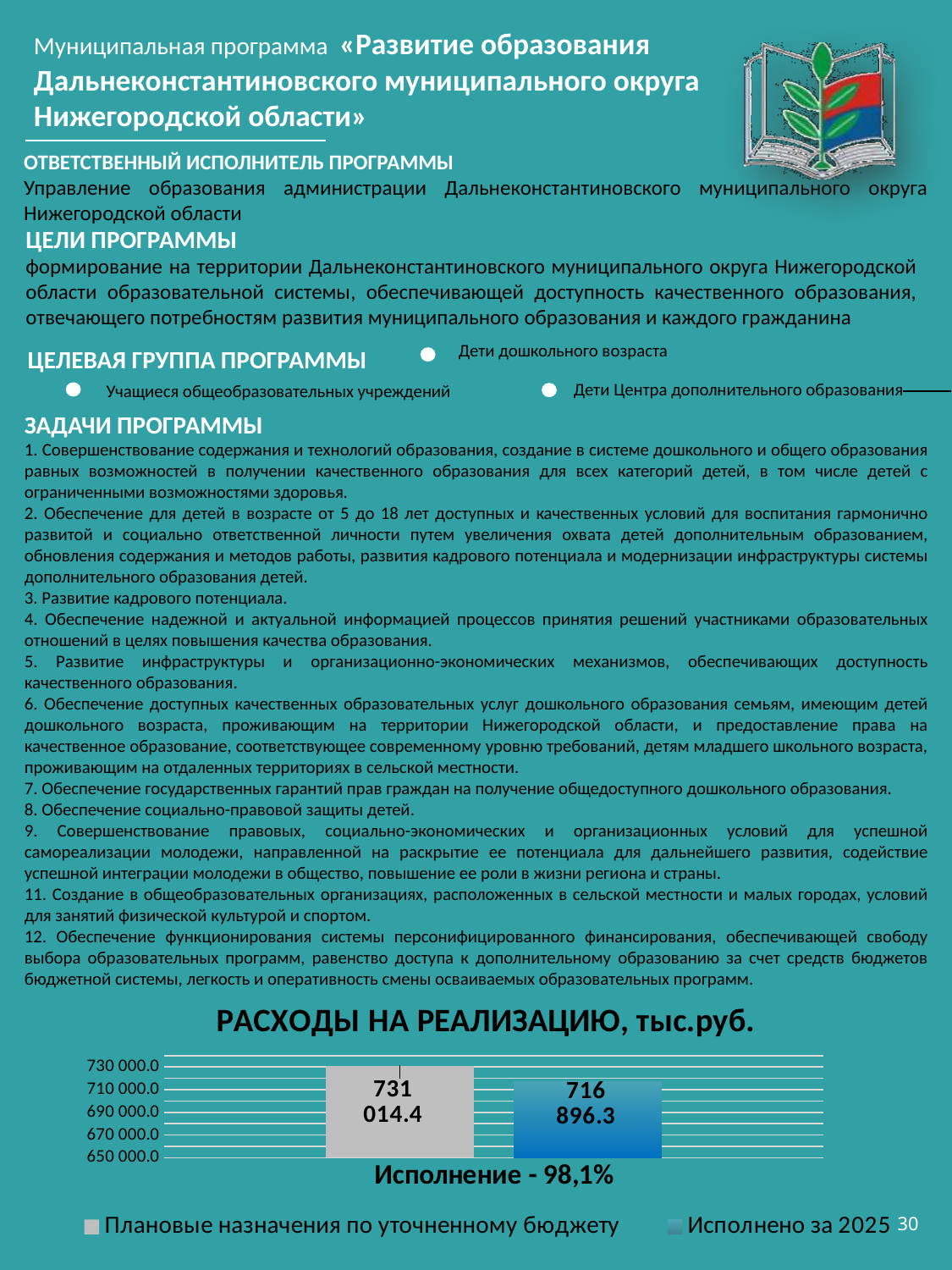
Which series has the lower value in the chart 'РАСХОДЫ НА РЕАЛИЗАЦИЮ, тыс.руб.'? Исполнено за 2025 How many series does the legend of the chart 'РАСХОДЫ НА РЕАЛИЗАЦИЮ, тыс.руб.' list? 2 What is the category label shown under the bars in the chart 'РАСХОДЫ НА РЕАЛИЗАЦИЮ, тыс.руб.'? Исполнение - 98,1% Is the value for 'Исполнено за 2025' in the chart 'РАСХОДЫ НА РЕАЛИЗАЦИЮ, тыс.руб.' greater or less than 730 000.0? less In the chart 'РАСХОДЫ НА РЕАЛИЗАЦИЮ, тыс.руб.', is the value for 'Исполнено за 2025' larger or smaller than the value for 'Плановые назначения по уточненному бюджету'? smaller What is the value of the bar for 'Плановые назначения по уточненному бюджету' in the chart 'РАСХОДЫ НА РЕАЛИЗАЦИЮ, тыс.руб.'? 731 014.4 How many bars are plotted in the chart 'РАСХОДЫ НА РЕАЛИЗАЦИЮ, тыс.руб.'? 2 What kind of chart is 'РАСХОДЫ НА РЕАЛИЗАЦИЮ, тыс.руб.'? bar chart What is the value of the bar for 'Исполнено за 2025' in the chart 'РАСХОДЫ НА РЕАЛИЗАЦИЮ, тыс.руб.'? 716 896.3 Which series has the higher value in the chart 'РАСХОДЫ НА РЕАЛИЗАЦИЮ, тыс.руб.'? Плановые назначения по уточненному бюджету What is the difference between the planned value (731 014.4) and the executed value (716 896.3) in the chart 'РАСХОДЫ НА РЕАЛИЗАЦИЮ, тыс.руб.'? 14 118.1 Is the value for 'Плановые назначения по уточненному бюджету' in the chart 'РАСХОДЫ НА РЕАЛИЗАЦИЮ, тыс.руб.' greater or less than 710 000.0? greater